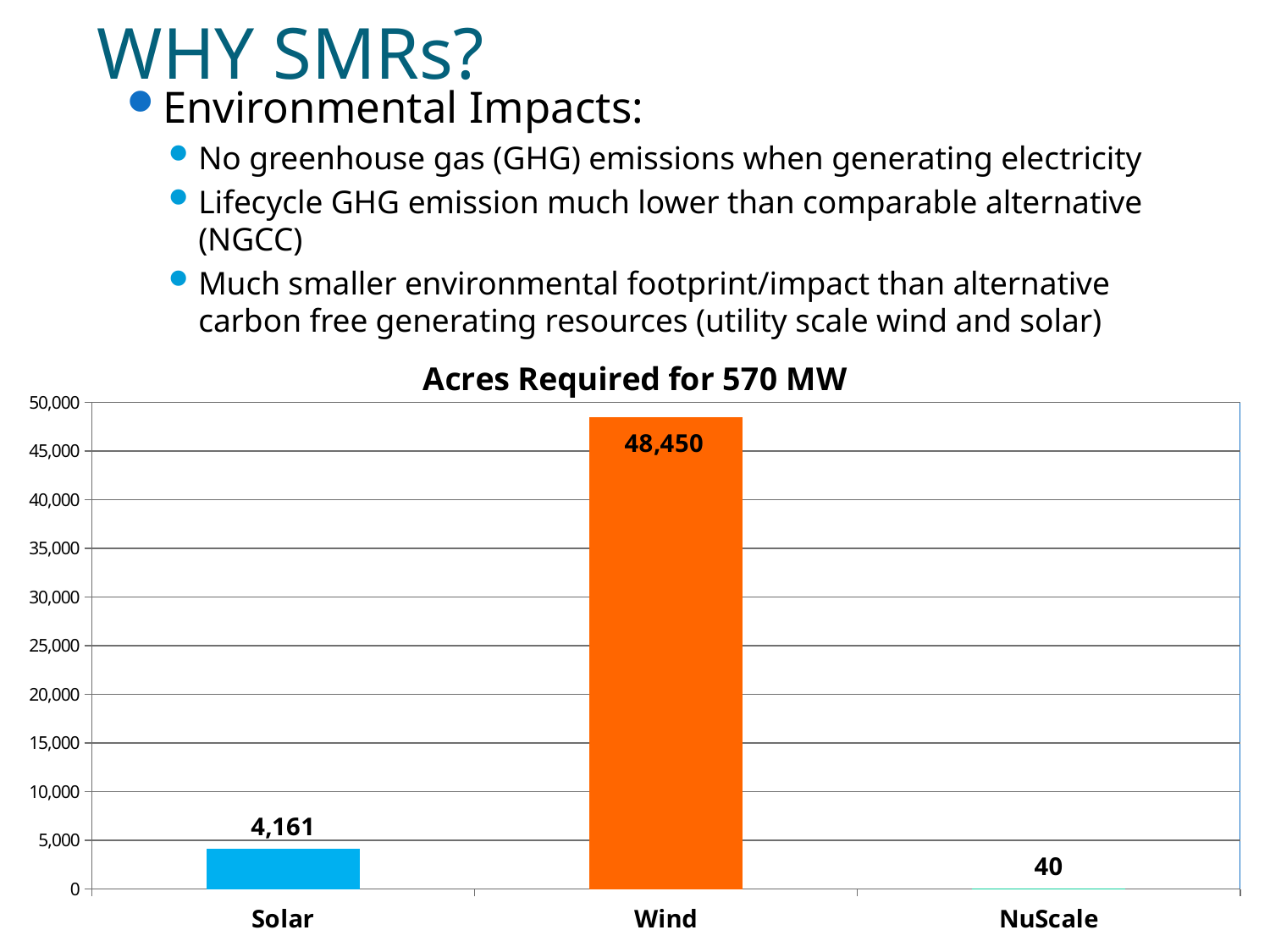
Which category requires the fewest acres in the chart? NuScale What is the difference between the Solar and NuScale values in the chart? 4,121 What is the difference between the Wind and Solar values in the chart? 44,289 What kind of chart is shown on the slide? Bar chart What is the value for Wind in the Acres Required for 570 MW chart? 48,450 How many categories are shown in the chart? 3 What is the value for NuScale in the Acres Required for 570 MW chart? 40 Which is larger in the chart, the value for Solar or the value for NuScale? Solar What is the title of the chart on the slide? Acres Required for 570 MW Which category requires the most acres in the chart? Wind What is the value for Solar in the Acres Required for 570 MW chart? 4,161 Is the value for Wind greater or less than 45,000? greater